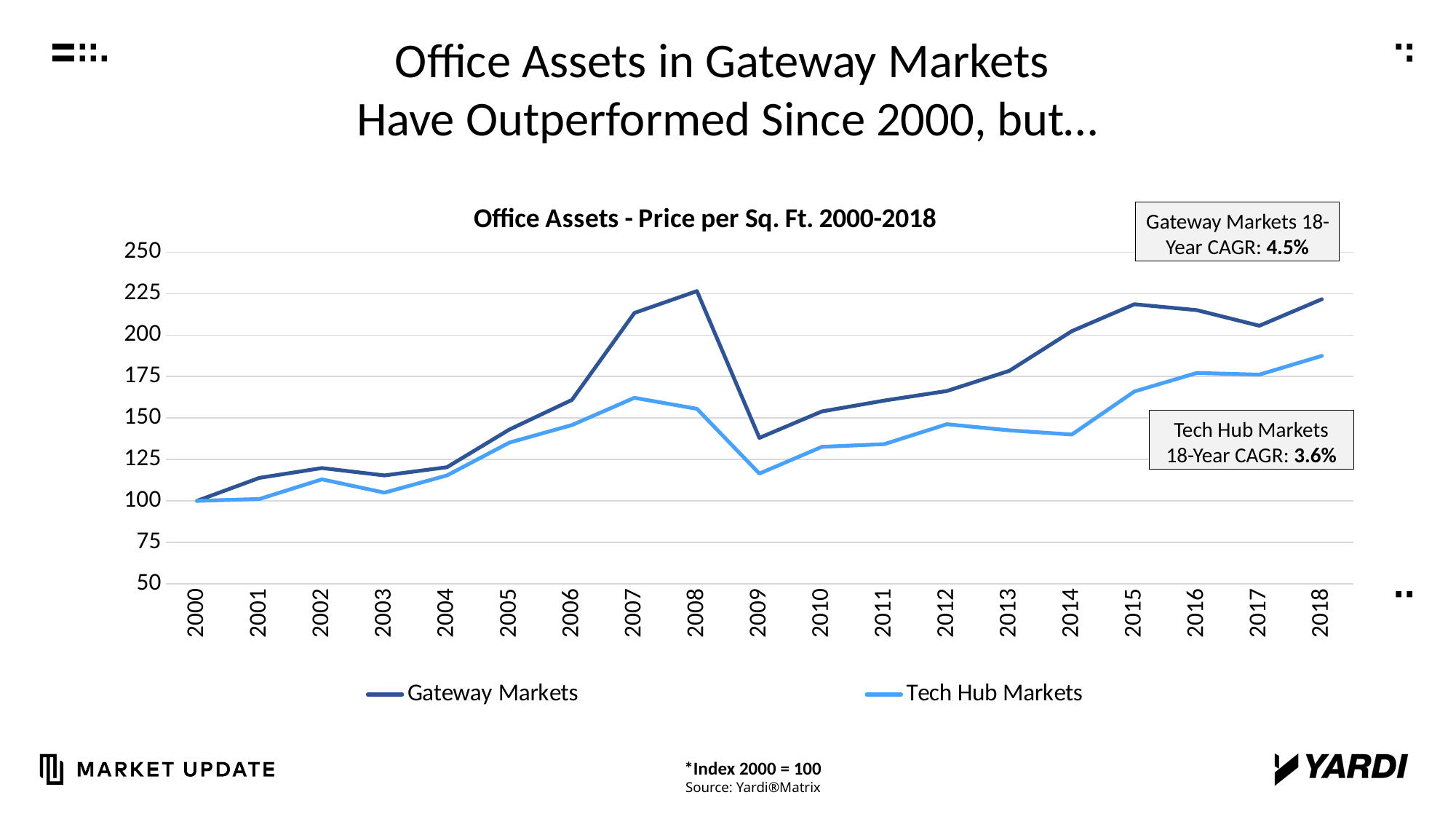
Which series has the larger value in 2008, Gateway Markets or Tech Hub Markets? Gateway Markets What kind of chart is shown on the slide? Line chart How many series does the legend list? 2 Is the value for Tech Hub Markets in 2018 greater or less than 175? greater In which year does the Gateway Markets line reach its highest value? 2008 Is the value for Tech Hub Markets in 2009 greater or less than 125? less How many years are plotted along the x axis? 19 What 18-year CAGR is shown for Tech Hub Markets? 3.6% Is the value for Gateway Markets in 2008 greater or less than 200? greater What is the value for Gateway Markets in 2000? 100 In which year does the Tech Hub Markets line reach its highest value? 2018 Do the Gateway Markets values rise or fall between 2008 and 2009? Fall